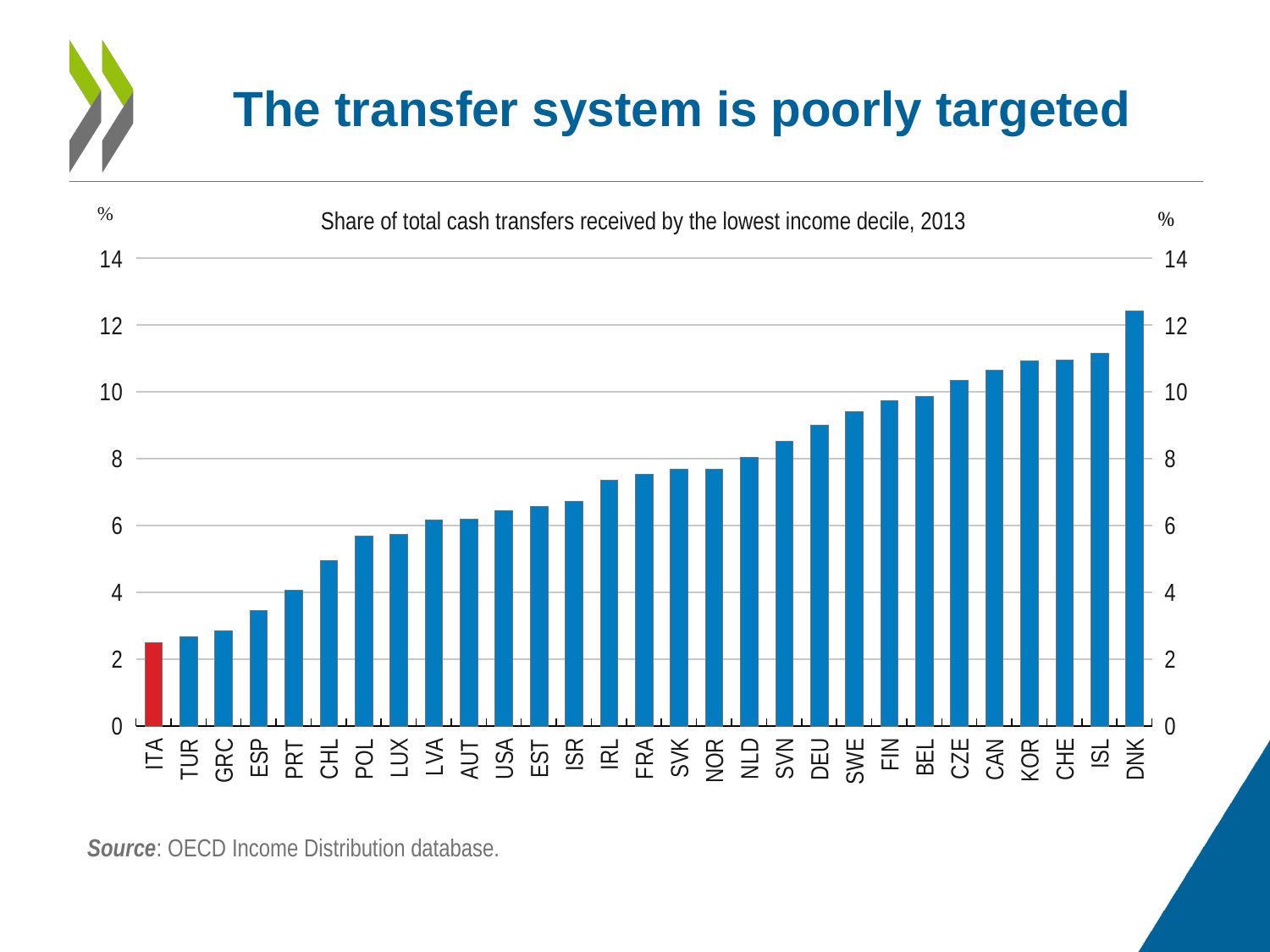
Is the value for CHL greater or less than 6? less Which has a larger value, ESP or USA? USA What is the title of the chart? Share of total cash transfers received by the lowest income decile, 2013 How many countries are shown on the x axis of the chart? 29 What kind of chart is shown on the slide? bar chart Which country has the highest share of total cash transfers received by the lowest income decile? DNK Which country's bar is coloured red rather than blue? ITA Is the value for ITA greater or less than 4? less Which country has the lowest share of total cash transfers received by the lowest income decile? ITA Is the value for DNK greater or less than 12? greater Do the bar values rise or fall moving from left to right along the x axis? rise